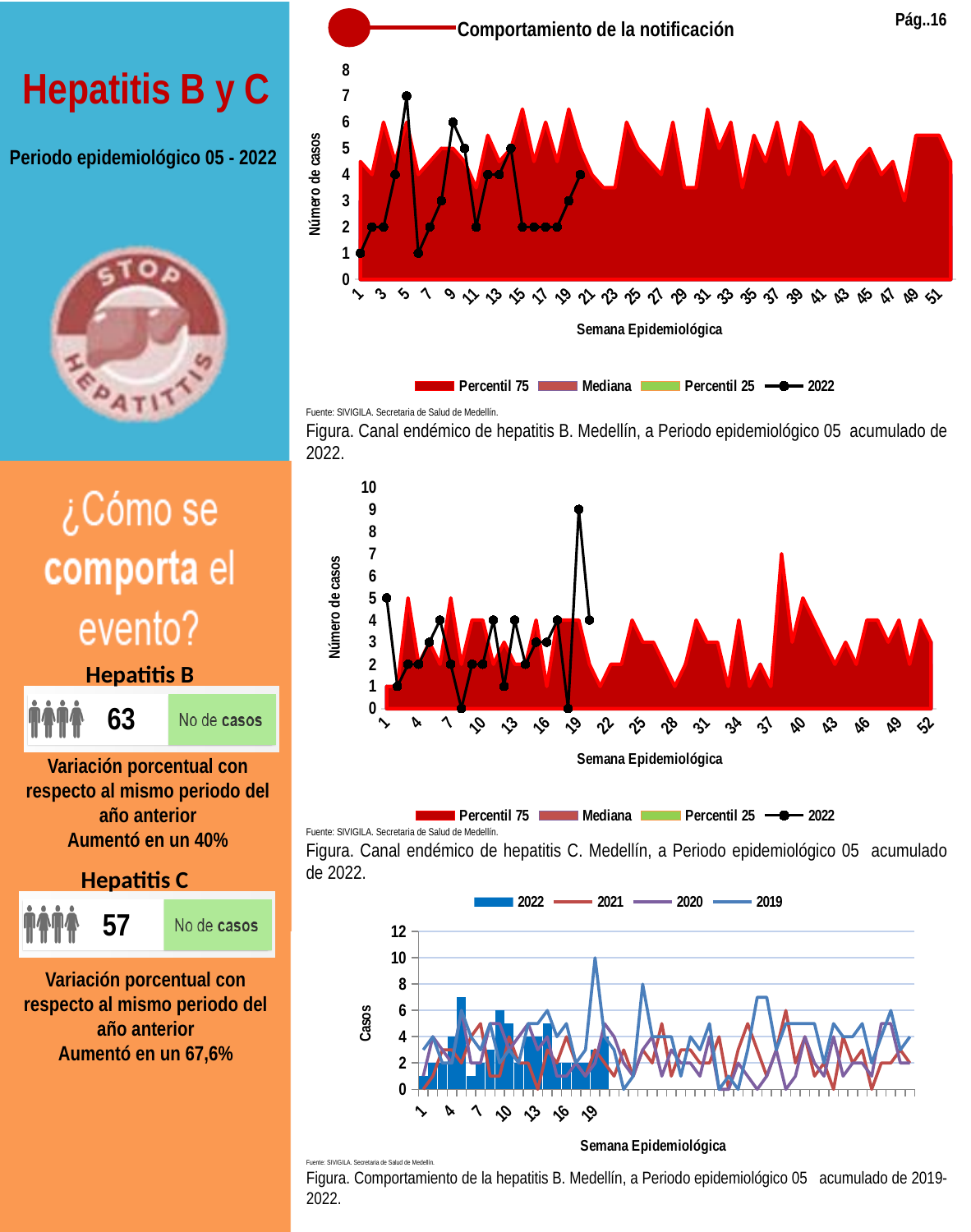
In the top chart (Canal endémico de hepatitis B), what is the label of the y axis? Número de casos In the bottom chart (Comportamiento de la hepatitis B 2019-2022), how many series does the legend list? 4 In the top chart (Canal endémico de hepatitis B), at which epidemiological week does the 2022 line reach its highest value? 5 In the middle chart (Canal endémico de hepatitis C), is the 2022 value at week 19 greater or less than 8? greater In the top chart (Canal endémico de hepatitis B), what is the value of the 2022 line at week 1? 1 In the bottom chart (Comportamiento de la hepatitis B 2019-2022), is the 2022 bar at week 5 greater or less than 6? greater In the middle chart (Canal endémico de hepatitis C), at which epidemiological week does the 2022 line reach its highest value? 19 In the top chart (Canal endémico de hepatitis B), how many series does the legend list? 4 In the middle chart (Canal endémico de hepatitis C), what is the value of the 2022 line at week 1? 5 In the bottom chart (Comportamiento de la hepatitis B 2019-2022), which year is shown as bars rather than a line? 2022 In the top chart (Canal endémico de hepatitis B), what is the value of the 2022 line at week 5? 7 In the middle chart (Canal endémico de hepatitis C), what is the value of the 2022 line at week 19? 9